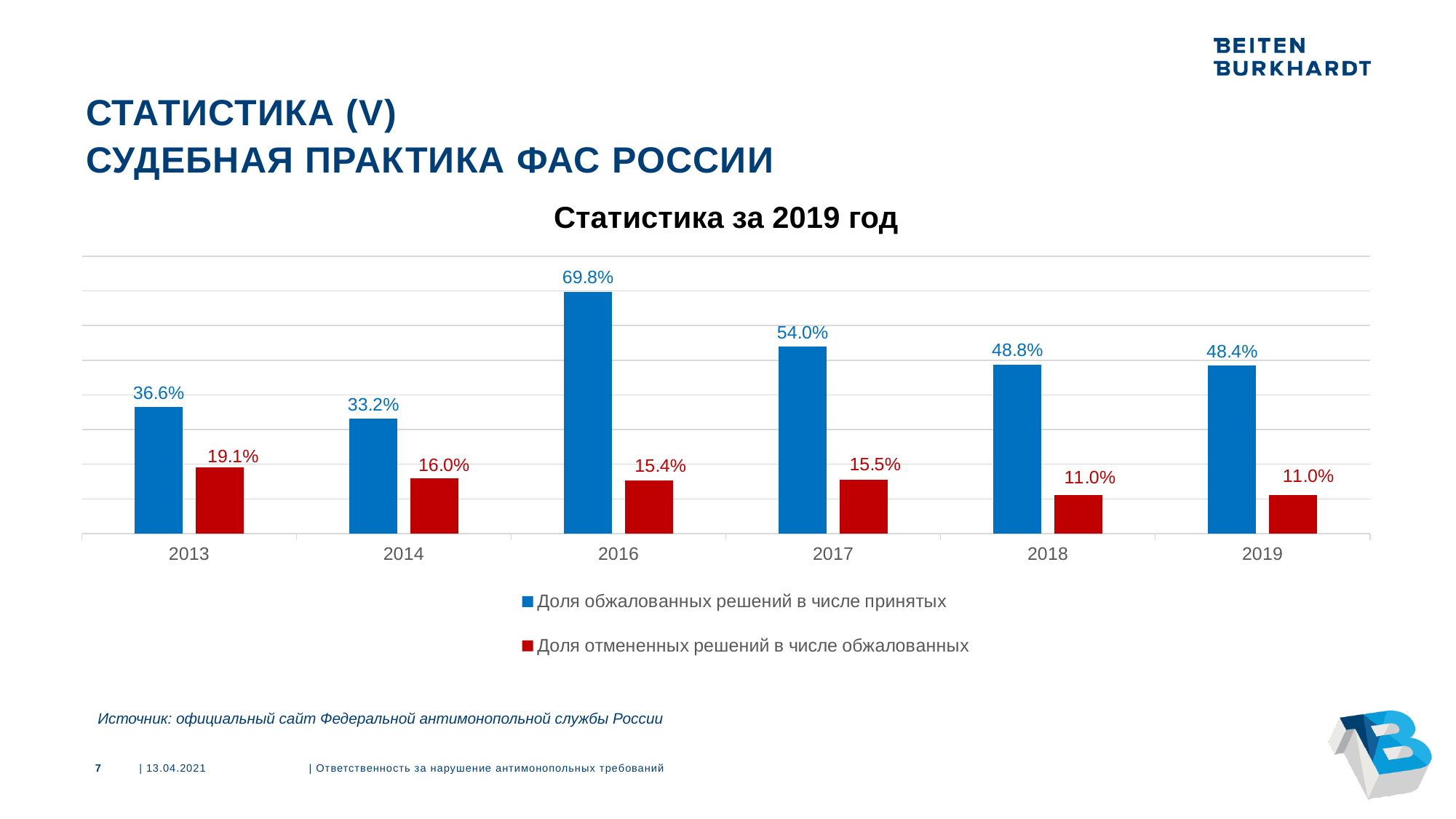
What is the value of 'Доля обжалованных решений в числе принятых' for 2019? 48.4% What is the value of 'Доля обжалованных решений в числе принятых' for 2016? 69.8% Which year has the highest value for 'Доля обжалованных решений в числе принятых'? 2016 Which is larger: 'Доля отмененных решений в числе обжалованных' for 2014 or for 2017? 2014 What is the title of the chart? Статистика за 2019 год What is the value of 'Доля отмененных решений в числе обжалованных' for 2013? 19.1% How many years are shown on the x axis of the chart? 6 Which year has the lowest value for 'Доля обжалованных решений в числе принятых'? 2014 Does 'Доля отмененных решений в числе обжалованных' rise or fall from 2017 to 2019? Fall How many series does the legend list? 2 What kind of chart is shown on the slide? Bar chart What is the difference between the 'Доля обжалованных решений в числе принятых' values for 2016 and 2017? 15.8%